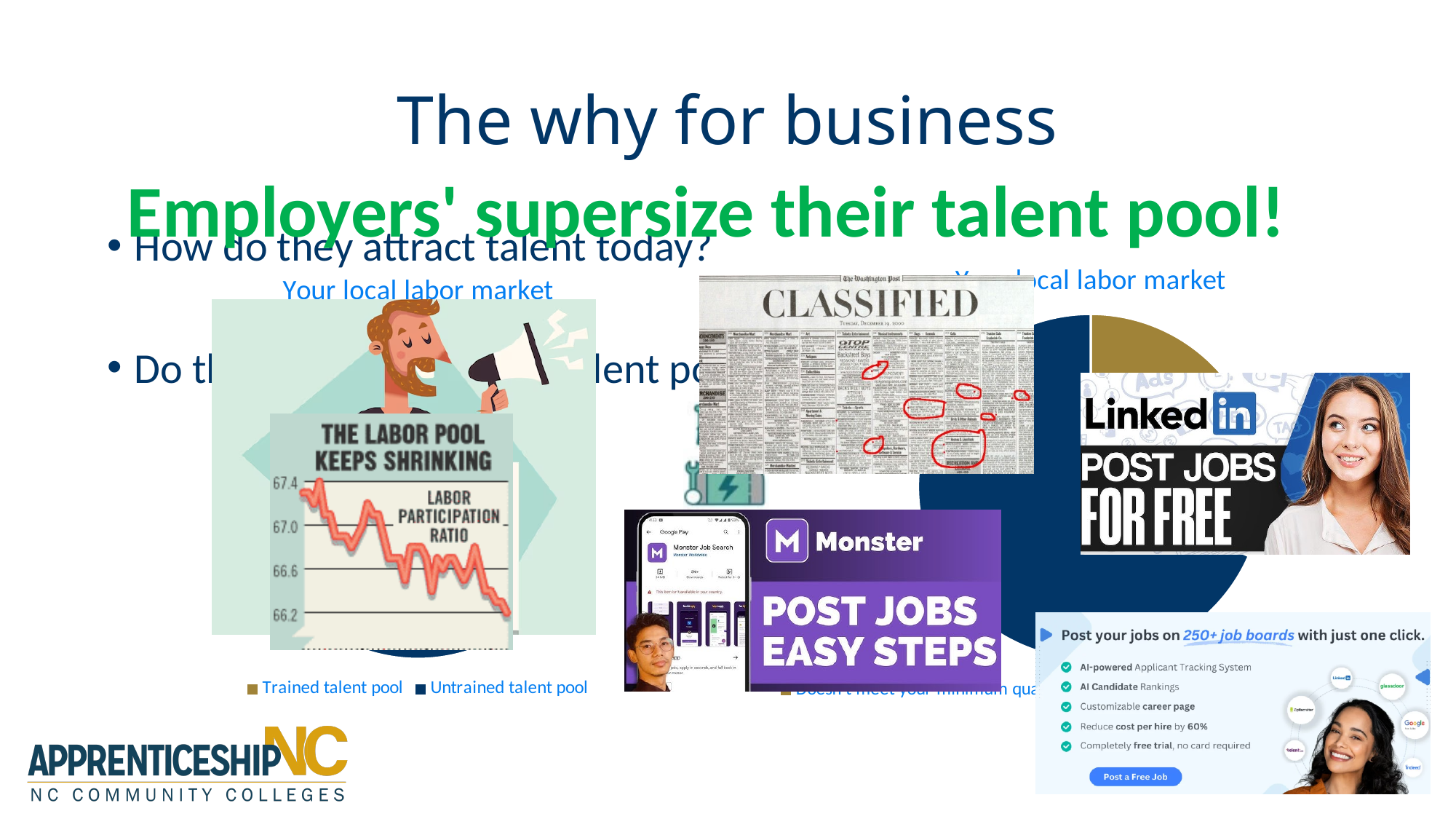
In the right 'Your local labor market' chart, is the gold slice larger or smaller than the dark blue slice? smaller What is the title of the pie chart on the left side of the slide? Your local labor market How many entries does the legend of the left 'Your local labor market' chart list? 2 What kind of chart is shown in the 'The labor pool keeps shrinking' image? line chart What quantity does the 'The labor pool keeps shrinking' chart plot? Labor participation ratio In the 'The labor pool keeps shrinking' chart, do the values rise or fall from left to right? fall What are the two legend entries of the left 'Your local labor market' chart? Trained talent pool, Untrained talent pool What kind of chart is the right 'Your local labor market' chart? pie chart How many tick labels are shown on the vertical axis of the 'The labor pool keeps shrinking' chart? 4